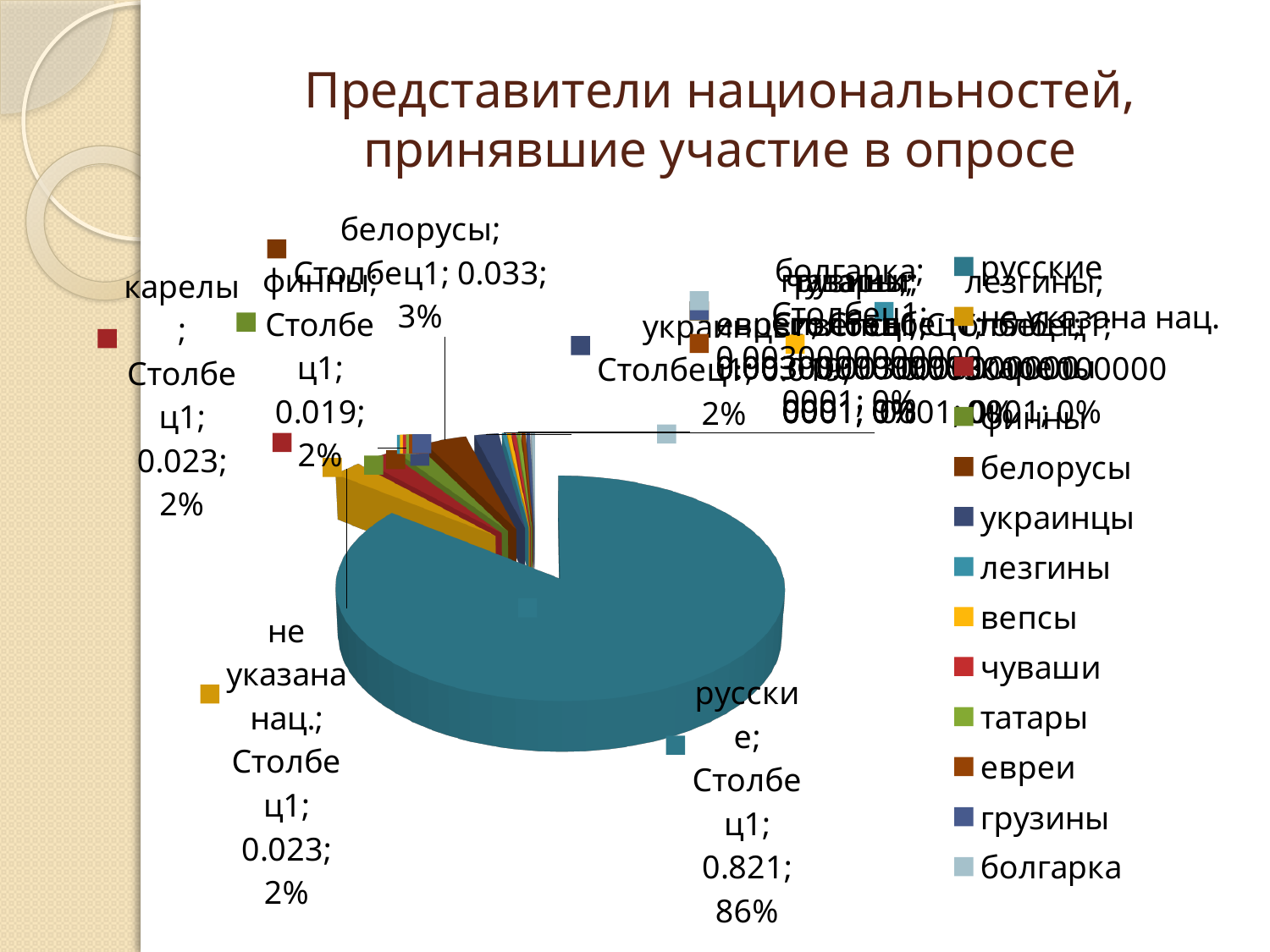
Which nationality has the largest slice of the pie? русские What value is shown for не указана нац. in the data label? 0.023 What kind of chart is shown on the slide? pie chart What is the title of the chart? Представители национальностей, принявшие участие в опросе What value is shown for русские in the data label? 0.821 What percentage share of the pie does карелы have? 2% What value is shown for финны in the data label? 0.019 How many categories does the legend list? 13 What value is shown for белорусы in the data label? 0.033 Which has the larger share: белорусы or финны? белорусы What percentage share of the pie does белорусы have? 3% What percentage share of the pie does русские have? 86%